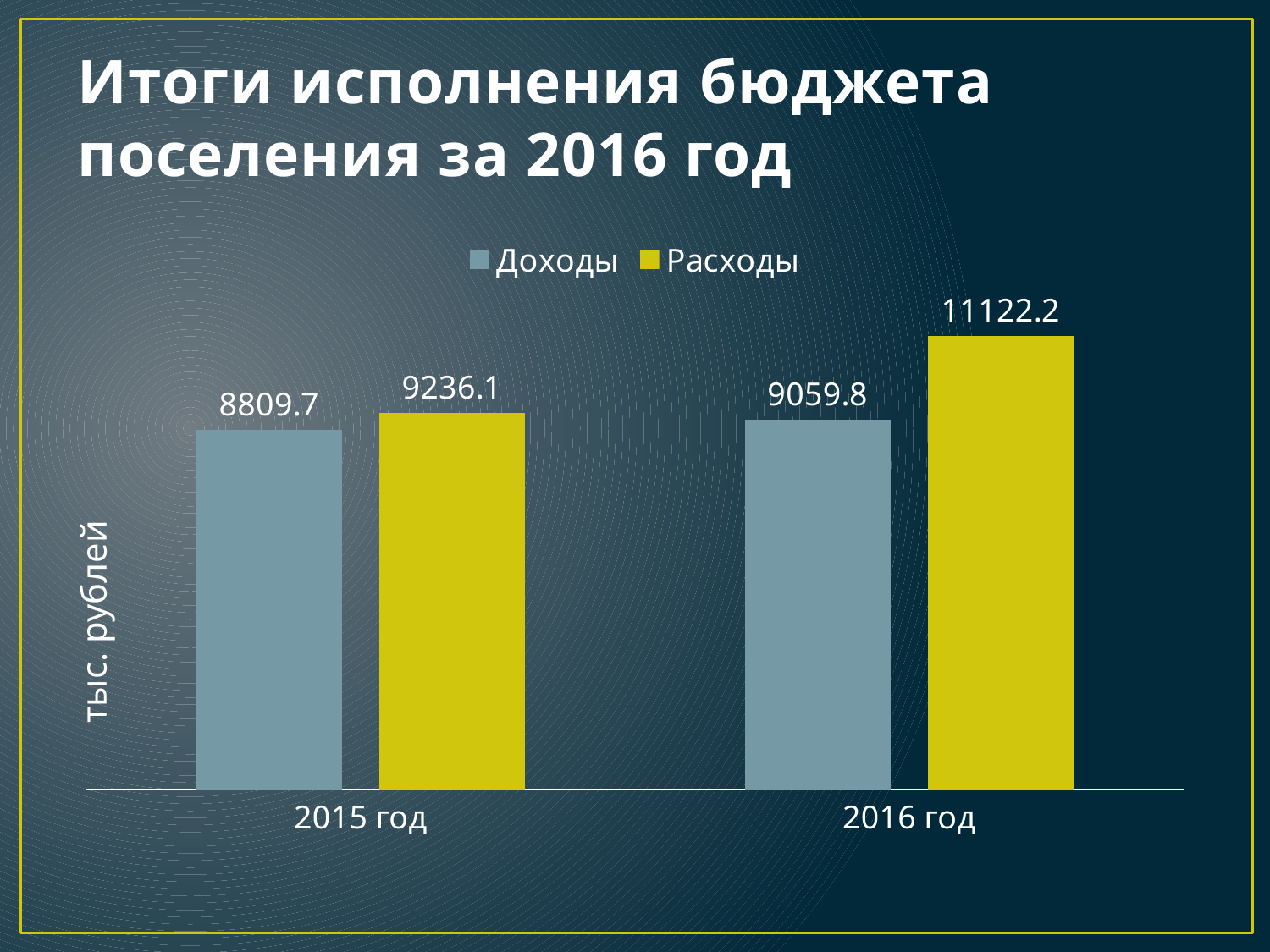
What is the value of Расходы for 2015 год? 9236.1 How many series does the legend list? 2 What is the value of Доходы for 2015 год? 8809.7 Which bar has the highest value on the chart? Расходы, 2016 год Which bar has the lowest value on the chart? Доходы, 2015 год What is the value of Расходы for 2016 год? 11122.2 What is the difference between Расходы and Доходы for 2015 год? 426.4 What kind of chart is shown on the slide? Bar chart What is the difference between Расходы and Доходы for 2016 год? 2062.4 What is the value of Доходы for 2016 год? 9059.8 Which is larger: Доходы for 2016 год or Расходы for 2015 год? Расходы for 2015 год What is the label on the vertical axis? тыс. рублей